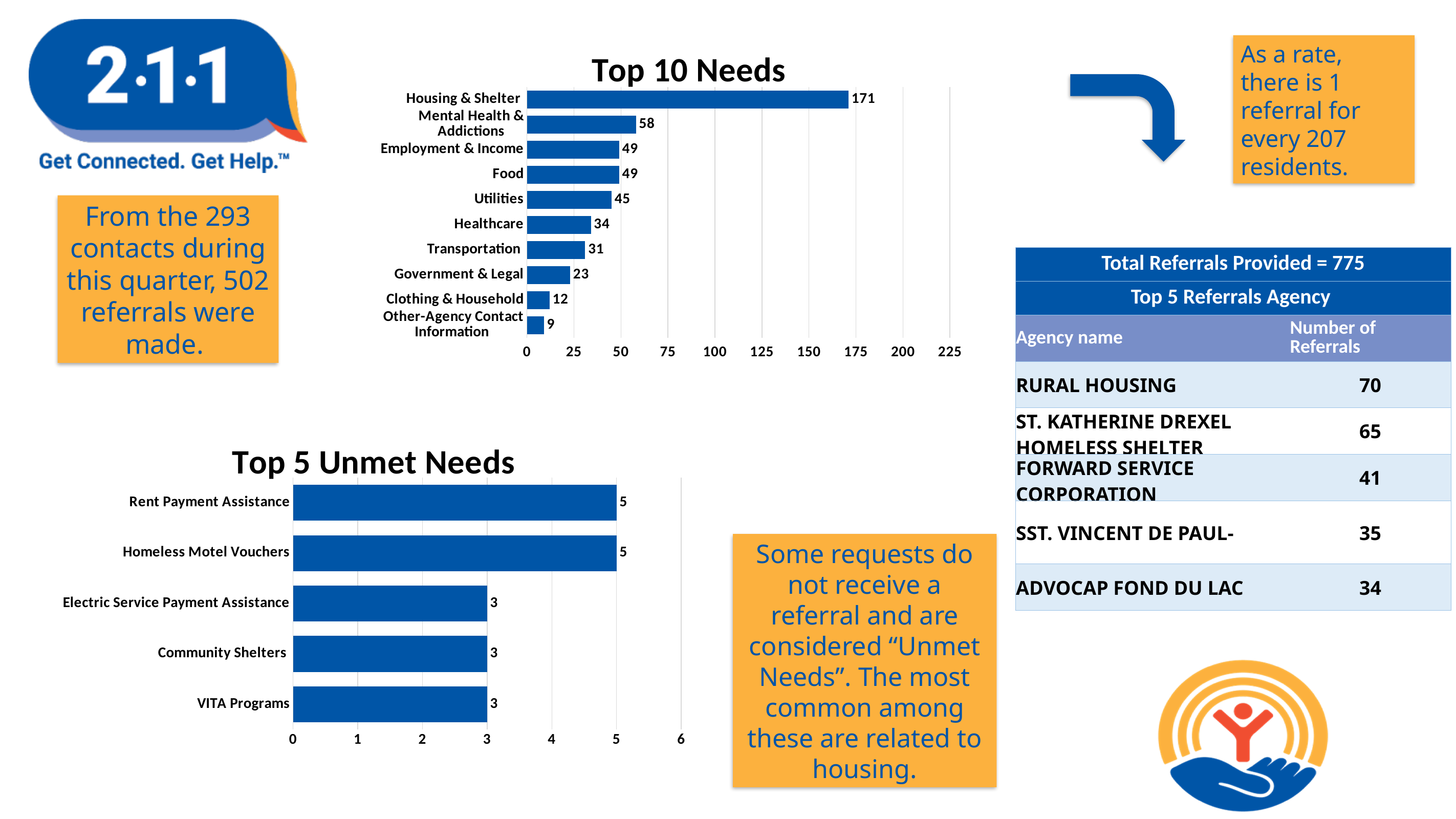
In the Top 10 Needs chart, what is the difference between Housing & Shelter and Mental Health & Addictions? 113 In the Top 5 Unmet Needs chart, what is the difference between Rent Payment Assistance and VITA Programs? 2 In the Top 10 Needs chart, what is the value for Utilities? 45 In the Top 10 Needs chart, is the value for Government & Legal greater or less than 25? less In the Top 10 Needs chart, which category has the highest value? Housing & Shelter In the Top 5 Unmet Needs chart, what is the value for Electric Service Payment Assistance? 3 What kind of chart is the Top 5 Unmet Needs chart? Bar chart In the Top 10 Needs chart, how many categories are shown? 10 In the Top 10 Needs chart, which is larger, Healthcare or Transportation? Healthcare In the Top 10 Needs chart, which category has the lowest value? Other-Agency Contact Information In the Top 10 Needs chart, what is the value for Housing & Shelter? 171 In the Top 5 Unmet Needs chart, how many categories are shown? 5